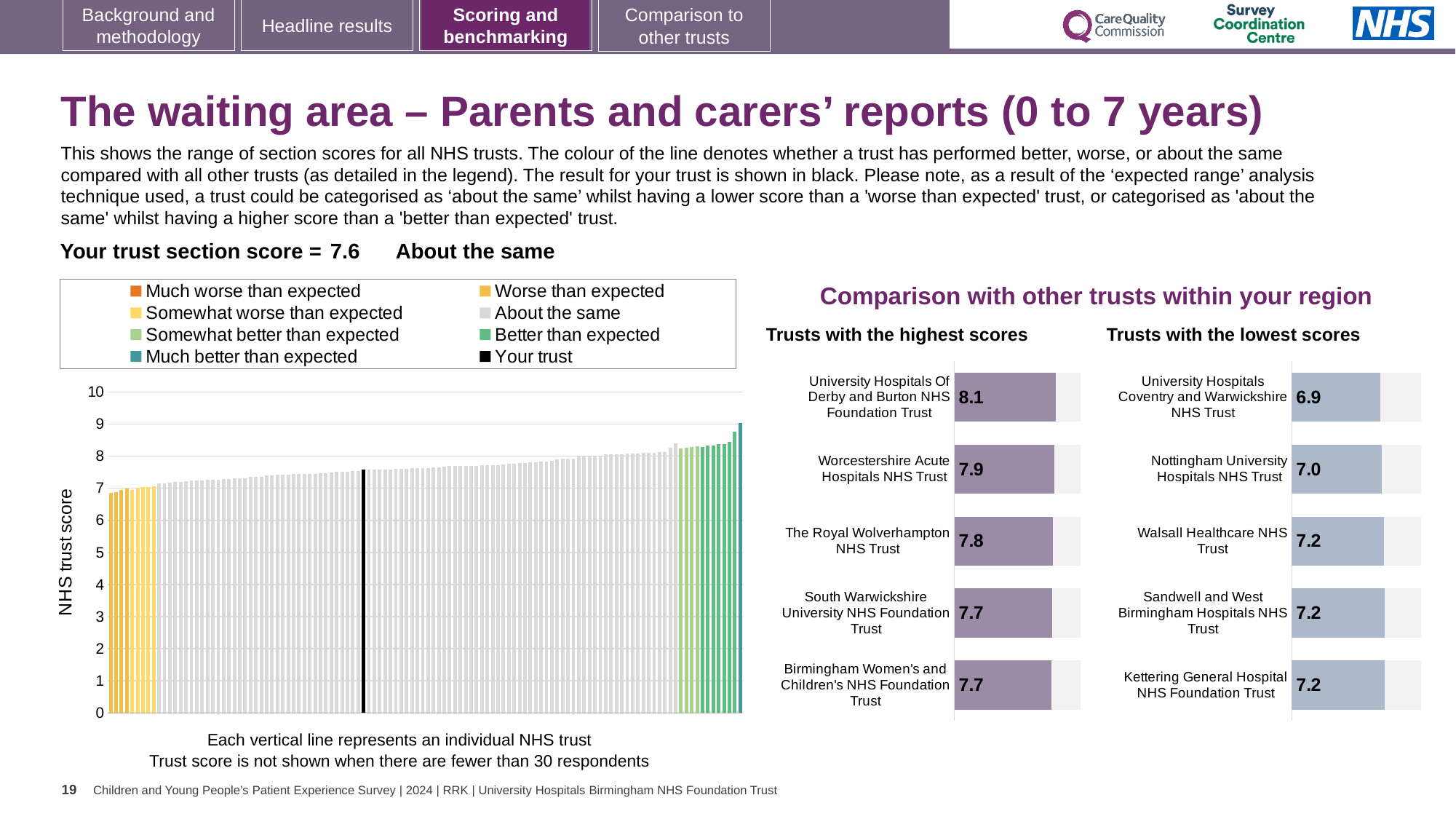
In the 'Trusts with the highest scores' chart, what is the score for University Hospitals Of Derby and Burton NHS Foundation Trust? 8.1 In the 'Trusts with the lowest scores' chart, what is the difference between the scores of Walsall Healthcare NHS Trust and University Hospitals Coventry and Warwickshire NHS Trust? 0.3 In the main chart on the left, do the trust scores rise or fall from left to right along the x axis? rise In the 'Trusts with the lowest scores' chart, what is the score for Nottingham University Hospitals NHS Trust? 7.0 In the 'Trusts with the highest scores' chart, which trust has the highest score? University Hospitals Of Derby and Burton NHS Foundation Trust Which has a higher score: Worcestershire Acute Hospitals NHS Trust in the highest scores chart or Nottingham University Hospitals NHS Trust in the lowest scores chart? Worcestershire Acute Hospitals NHS Trust How many entries does the legend of the main chart on the left list? 8 How many trusts are listed in the 'Trusts with the lowest scores' chart? 5 In the 'Trusts with the highest scores' chart, what is the difference between the scores of University Hospitals Of Derby and Burton NHS Foundation Trust and Worcestershire Acute Hospitals NHS Trust? 0.2 In the 'Trusts with the lowest scores' chart, which trust has the lowest score? University Hospitals Coventry and Warwickshire NHS Trust In the main chart on the left showing all NHS trusts, what is the section score for your trust (the black bar)? 7.6 In the 'Trusts with the highest scores' chart, what is the score for The Royal Wolverhampton NHS Trust? 7.8